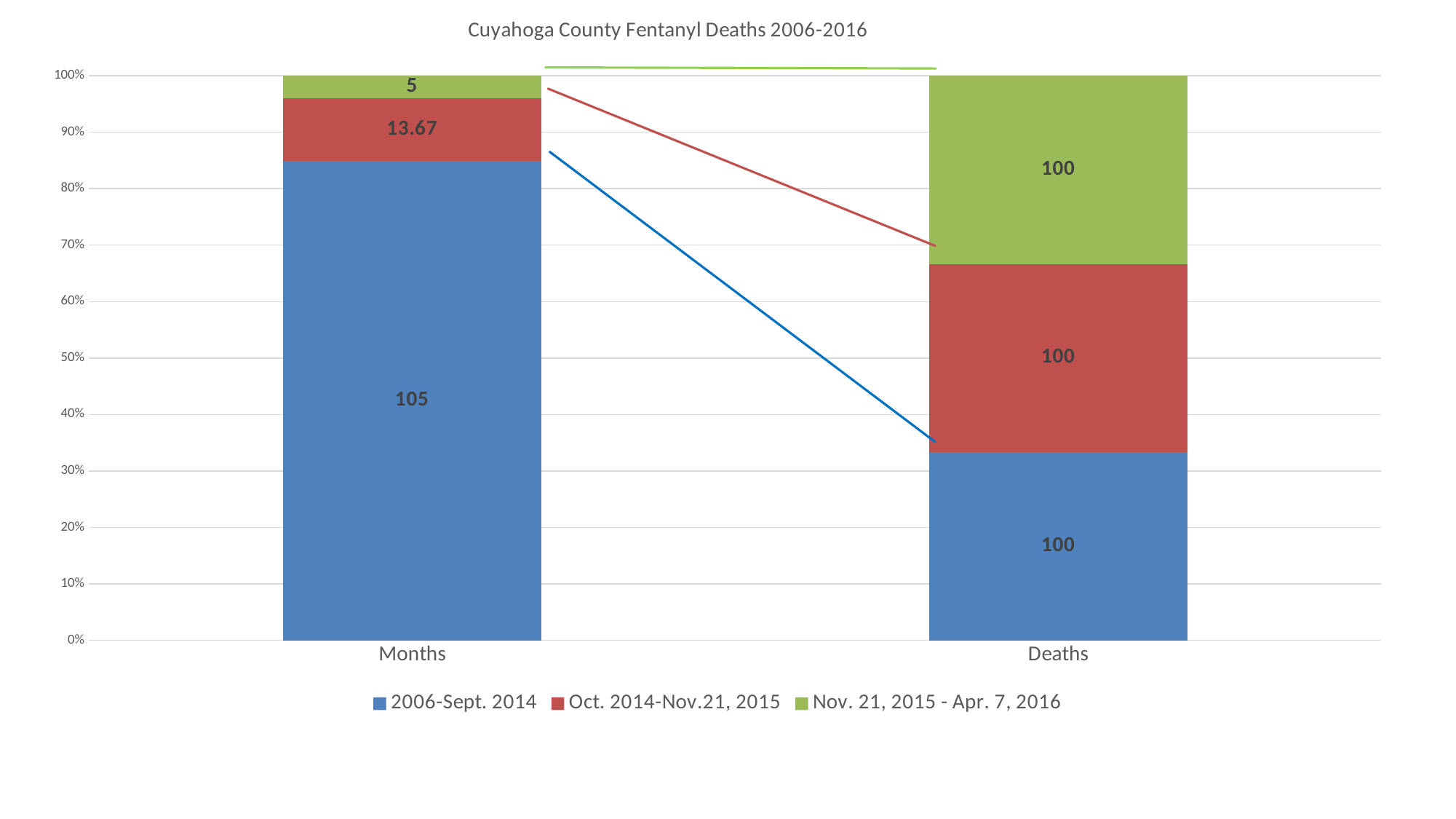
How many series does the legend list? 3 What is the value for Nov. 21, 2015 - Apr. 7, 2016 in the Months bar? 5 Which series has the highest value in the Months bar? 2006-Sept. 2014 What kind of chart is shown on the slide? Stacked bar chart What is the chart's title? Cuyahoga County Fentanyl Deaths 2006-2016 What is the total of the three values in the Deaths bar? 300 What is the value for 2006-Sept. 2014 in the Months bar? 105 How many categories are shown on the x axis? 2 Which series has the lowest value in the Months bar? Nov. 21, 2015 - Apr. 7, 2016 What is the value for Oct. 2014-Nov.21, 2015 in the Months bar? 13.67 What is the value for Oct. 2014-Nov.21, 2015 in the Deaths bar? 100 What is the difference between the 2006-Sept. 2014 and Oct. 2014-Nov.21, 2015 values in the Months bar? 91.33